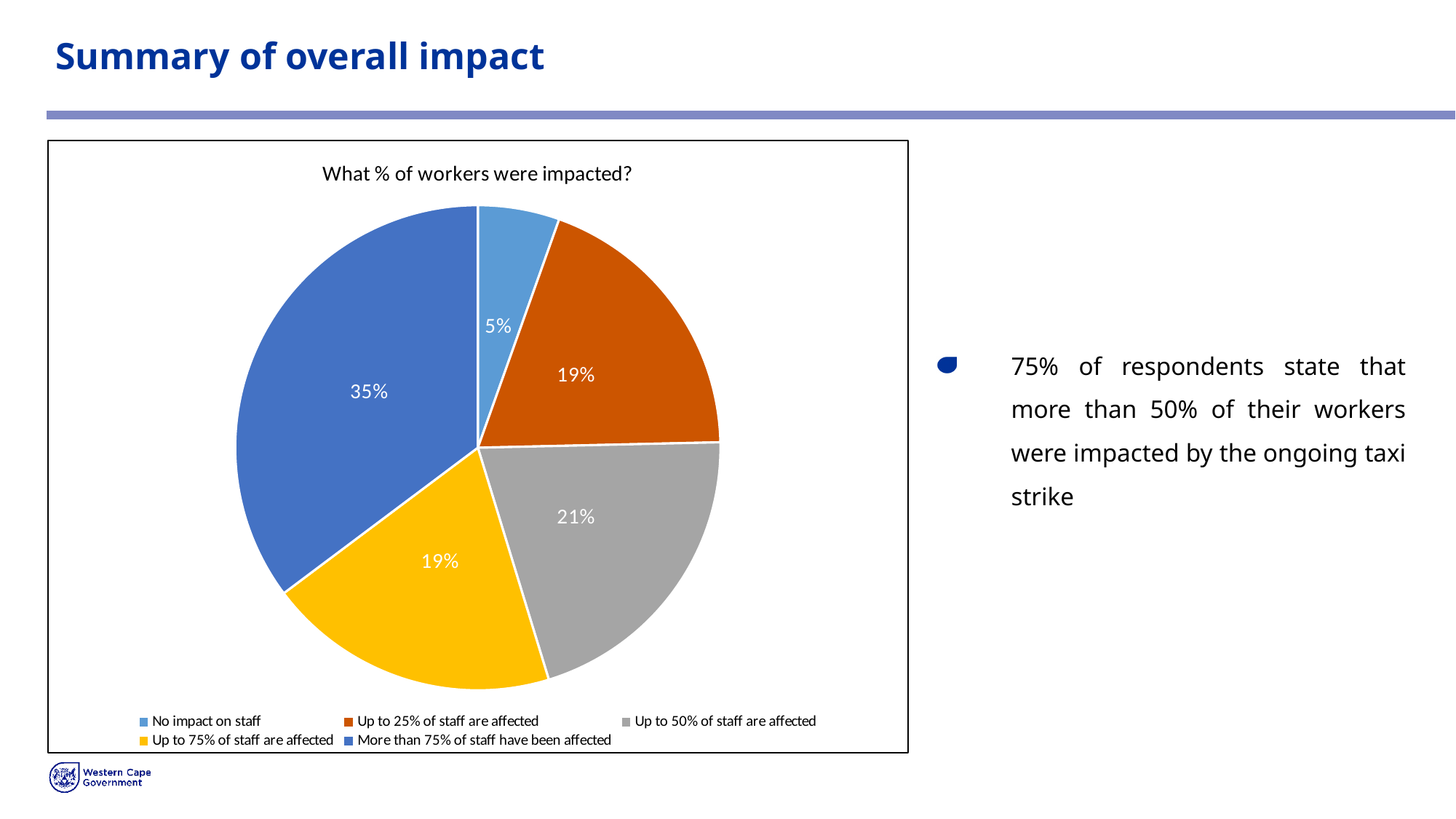
What is the title of the chart? What % of workers were impacted? What share of the pie is 'Up to 50% of staff are affected'? 21% Which is larger: the slice for 'Up to 50% of staff are affected' or the slice for 'Up to 75% of staff are affected'? Up to 50% of staff are affected What is the difference in percentage points between 'More than 75% of staff have been affected' and 'Up to 50% of staff are affected'? 14 What share of the pie is 'Up to 25% of staff are affected'? 19% What share of the pie is 'More than 75% of staff have been affected'? 35% Which category has the largest slice of the pie? More than 75% of staff have been affected What kind of chart is shown on the slide? pie chart How many categories does the pie chart show? 5 What share of the pie is 'No impact on staff'? 5% What colour is the slice for 'Up to 75% of staff are affected'? yellow Which category has the smallest slice of the pie? No impact on staff